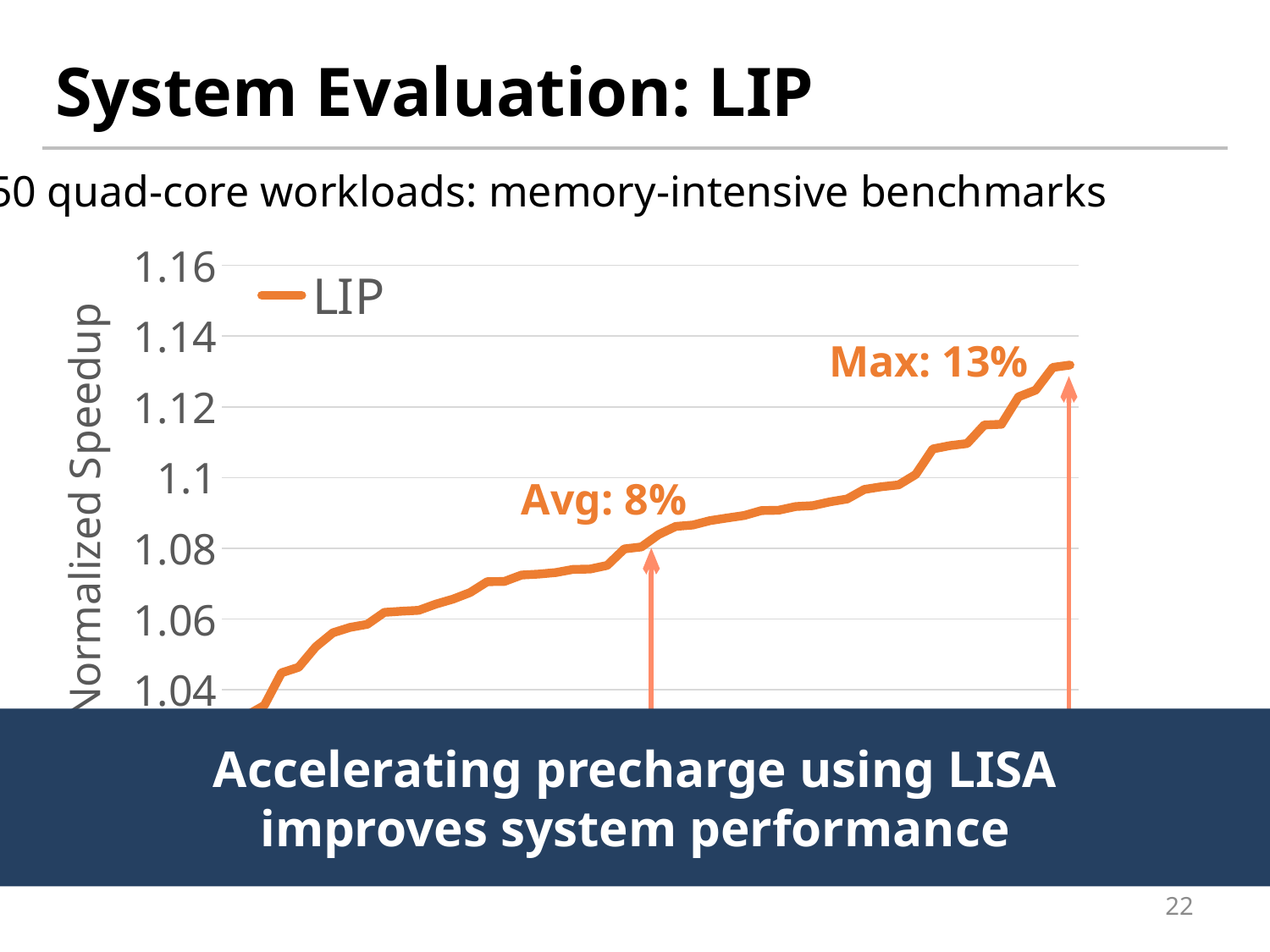
What is the label on the y axis? Normalized Speedup Do the LIP values rise or fall from left to right along the x axis? rise What kind of chart is shown on the slide? line chart What maximum speedup is annotated on the chart? 13% What average speedup is annotated on the chart? 8% How many series does the legend list? 1 What is the name of the series shown in the legend? LIP What is the highest tick value shown on the y axis? 1.16 Is the value at the point marked 'Avg: 8%' greater or less than 1.1? less Is the highest point of the LIP line greater or less than 1.12? greater Is the highest point of the LIP line greater or less than 1.14? less